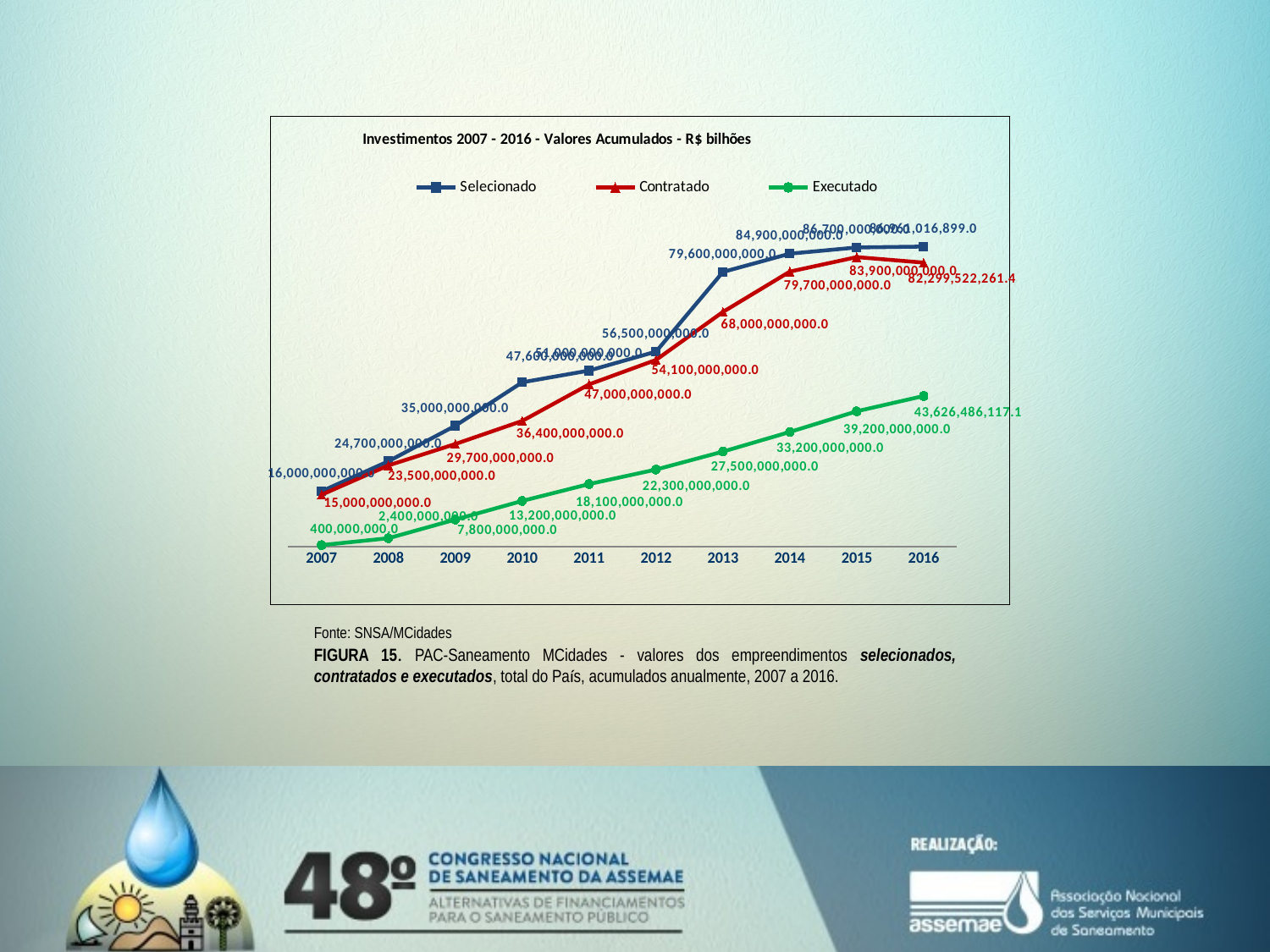
What type of chart is shown on the slide? line chart What is the difference between the Contratado and Executado values in 2012? 31,800,000,000.0 Does the Executado series rise or fall from 2007 to 2016? rise Which is larger in 2010: the Selecionado value or the Contratado value? Selecionado In which year is the Contratado series highest? 2015 What is the Selecionado value for 2014? 84,900,000,000.0 In which year is the Executado series lowest? 2007 How many years are plotted along the x axis? 10 What is the Contratado value for 2013? 68,000,000,000.0 What is the Executado value for 2016? 43,626,486,117.1 How many series does the legend list? 3 What is the Executado value for 2007? 400,000,000.0